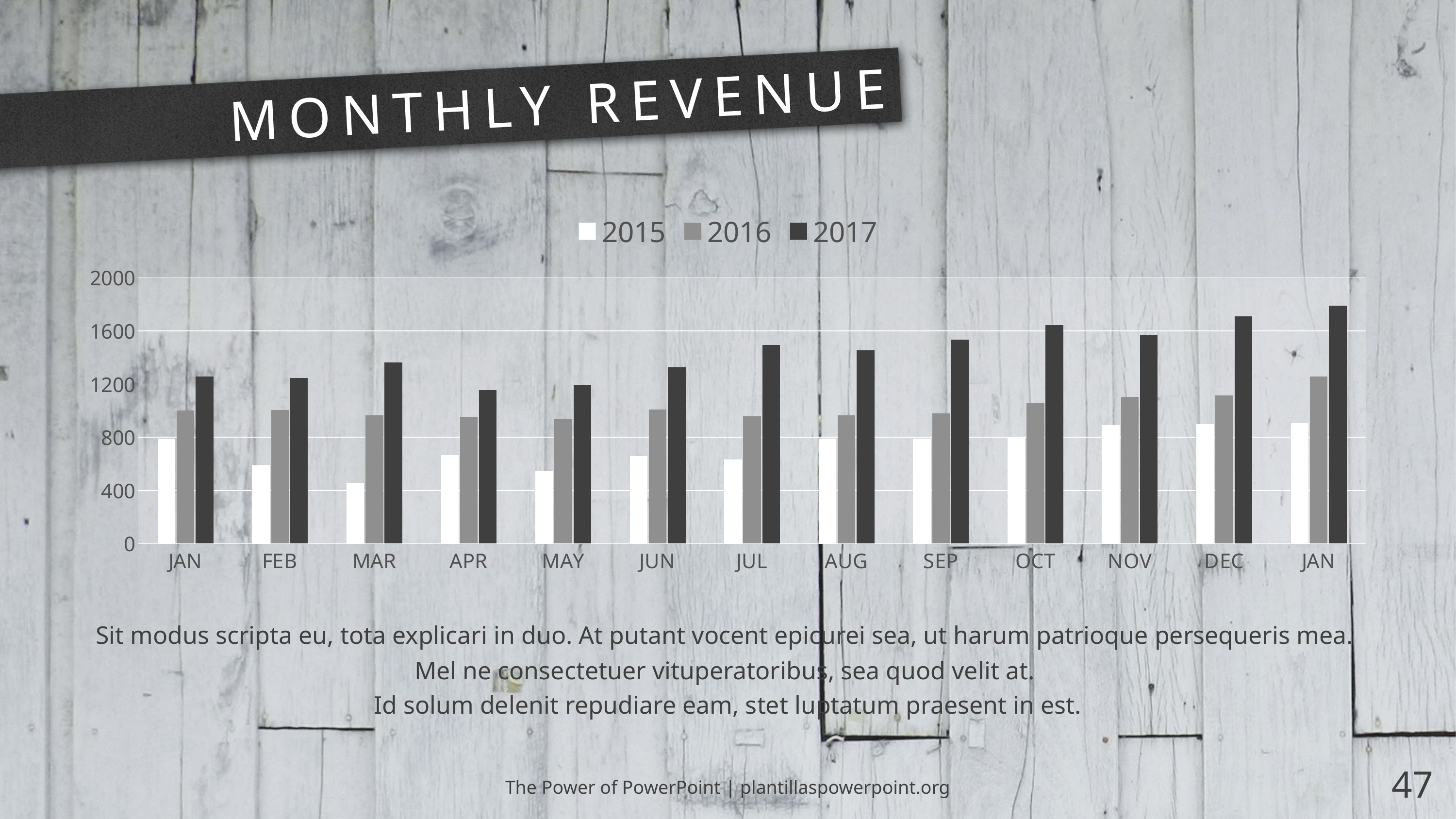
In which month does the 2017 series reach its highest value? JAN (the last one) In AUG, which series has the larger value, 2015 or 2017? 2017 Is the 2017 value for MAR greater or less than 1200? greater Which series is drawn in white bars? 2015 What is the title of the slide's chart? Monthly Revenue What kind of chart is shown on the slide? bar chart How many month categories are shown on the x axis? 13 Is the 2016 value for OCT greater or less than 800? greater Is the 2017 value for the final JAN greater or less than 1600? greater How many series does the legend list? 3 In which month is the 2015 value lowest? MAR